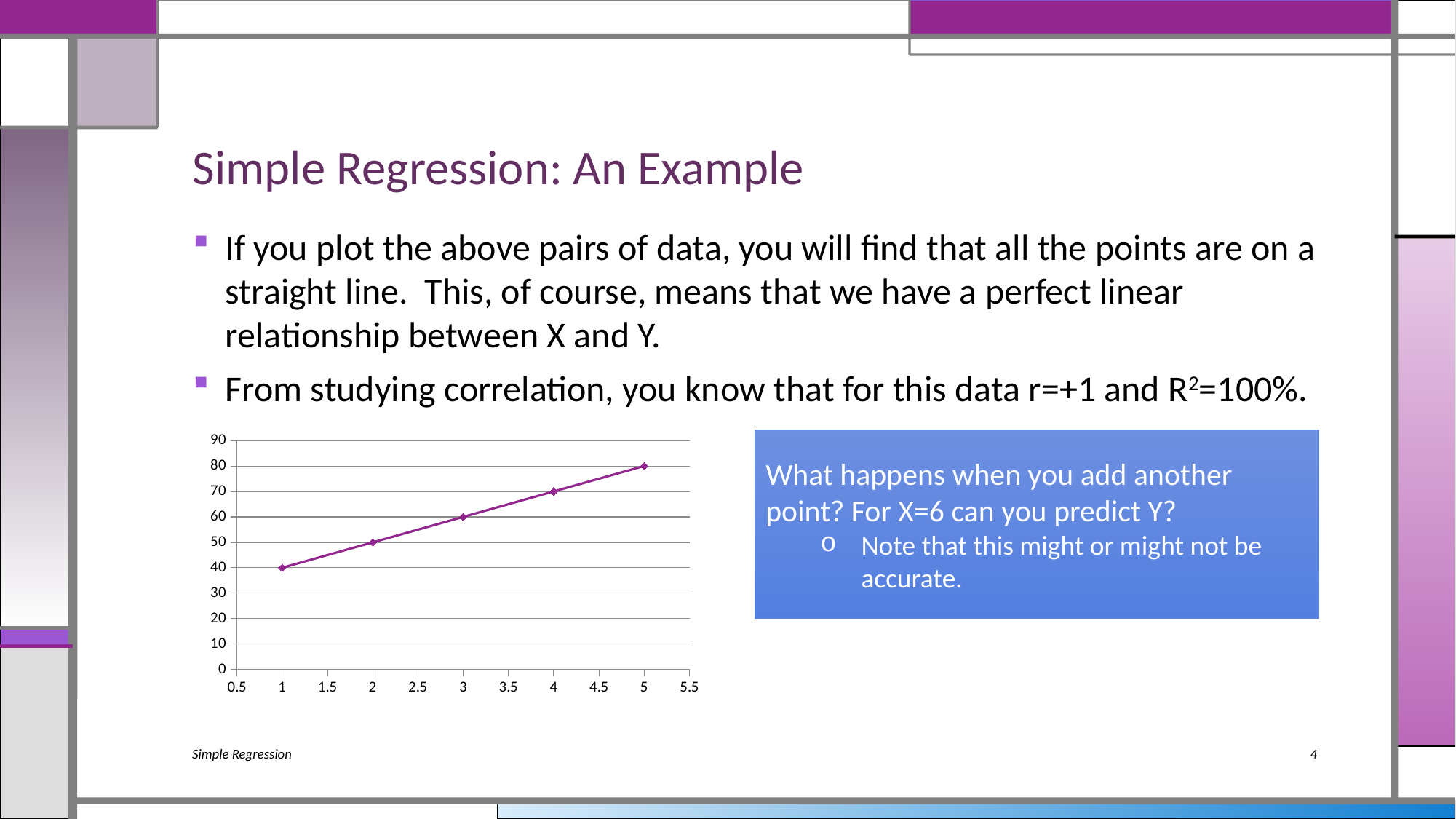
What is the maximum value shown on the vertical axis? 90 What is the Y value at X=1? 40 Do the Y values rise or fall as X increases? rise How many data points are plotted on the chart? 5 What is the Y value at X=3? 60 What is the difference between the Y value at X=5 and the Y value at X=1? 40 What colour is the plotted line? purple What type of chart is shown on the slide? line chart At which X value is Y lowest? 1 Which is larger, the Y value at X=2 or the Y value at X=4? X=4 What is the Y value at X=5? 80 At which X value is Y highest? 5